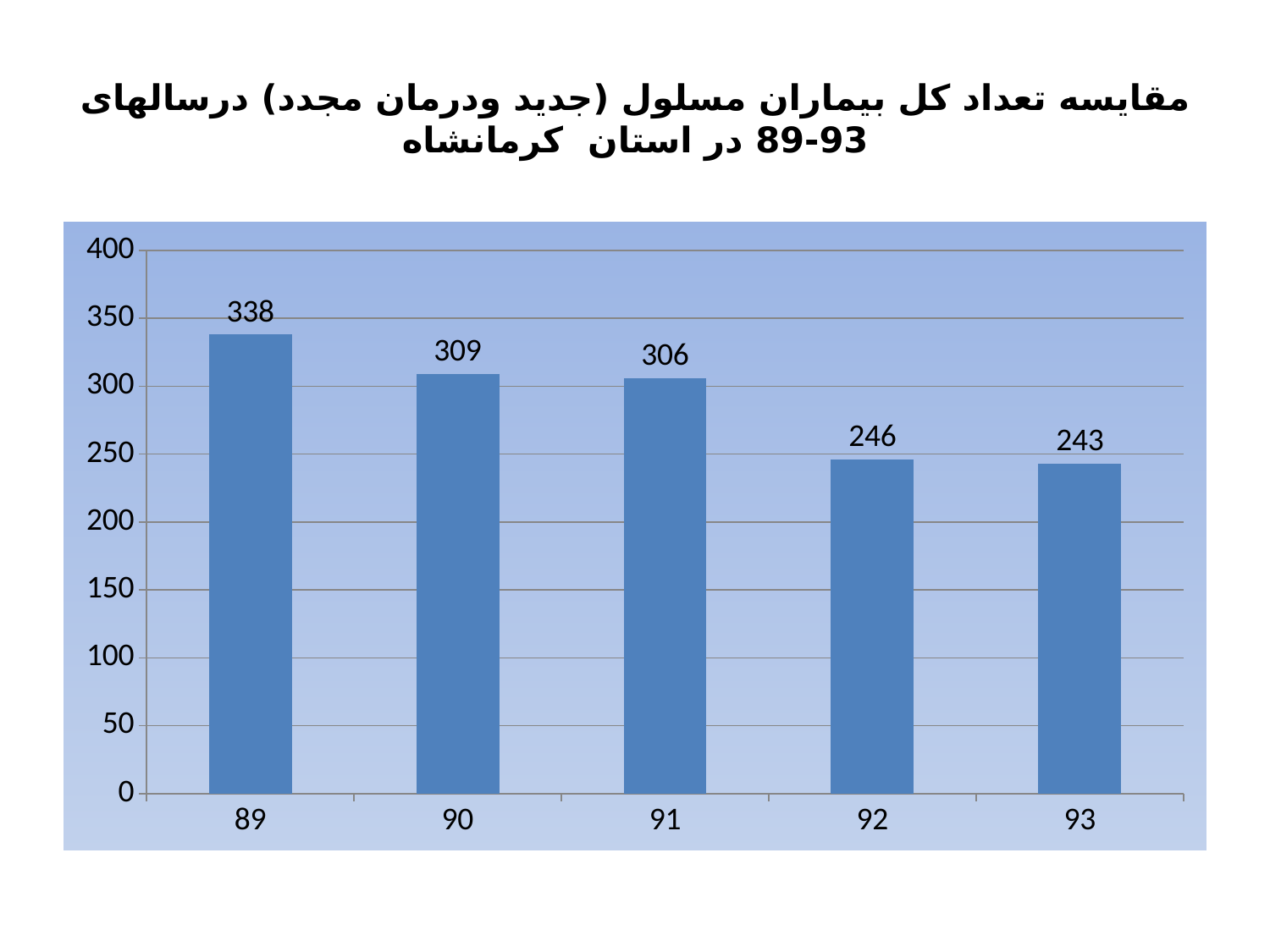
What is the difference between the values for 90 and 91? 3 How many years are shown on the x axis? 5 Which year has the lowest value? 93 What is the value for year 92? 246 What is the value for year 93? 243 Which is larger, the value for 90 or the value for 92? 90 What is the difference between the values for 89 and 93? 95 Which year has the highest value? 89 Is the value for 91 greater or less than 300? greater What kind of chart is shown on the slide? bar chart Do the values rise or fall from 89 to 93? fall What is the value for year 89? 338